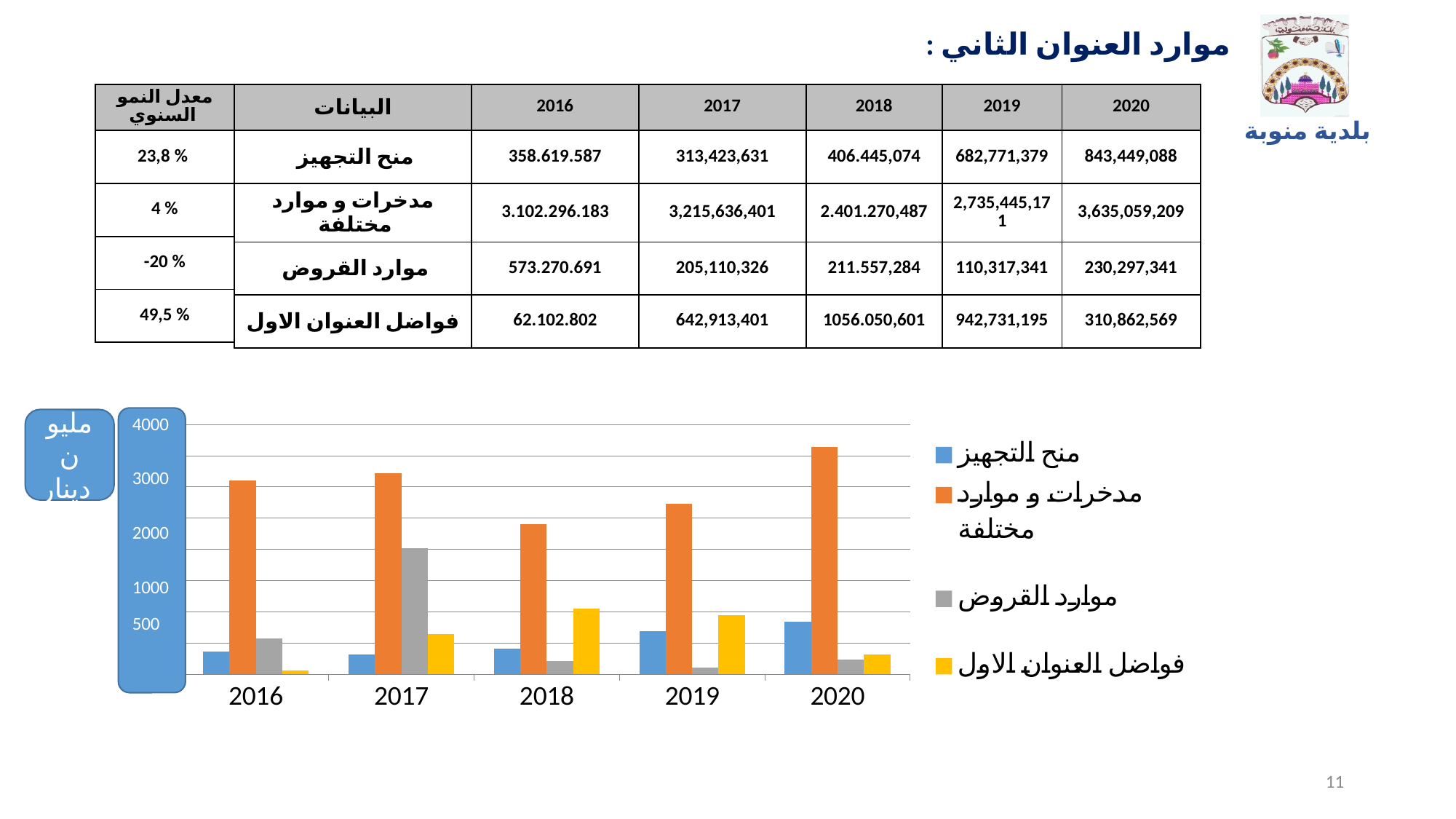
Is the value for موارد القروض in 2017 greater or less than 1000? greater In which year is the bar for مدخرات و موارد مختلفة the highest? 2020 What kind of chart is shown on the slide? bar chart Is the value for مدخرات و موارد مختلفة in 2020 greater or less than 3000? greater In which year is the bar for موارد القروض the highest? 2017 How many series does the chart legend list? 4 Which series has the tallest bar in every year of the chart? مدخرات و موارد مختلفة In which year is the bar for مدخرات و موارد مختلفة the lowest? 2018 In which year is the bar for فواضل العنوان الاول the highest? 2018 Is the value for منح التجهيز in 2020 greater or less than 1000? less In 2018, which is larger: فواضل العنوان الاول or منح التجهيز? فواضل العنوان الاول How many years are shown on the x axis of the chart? 5